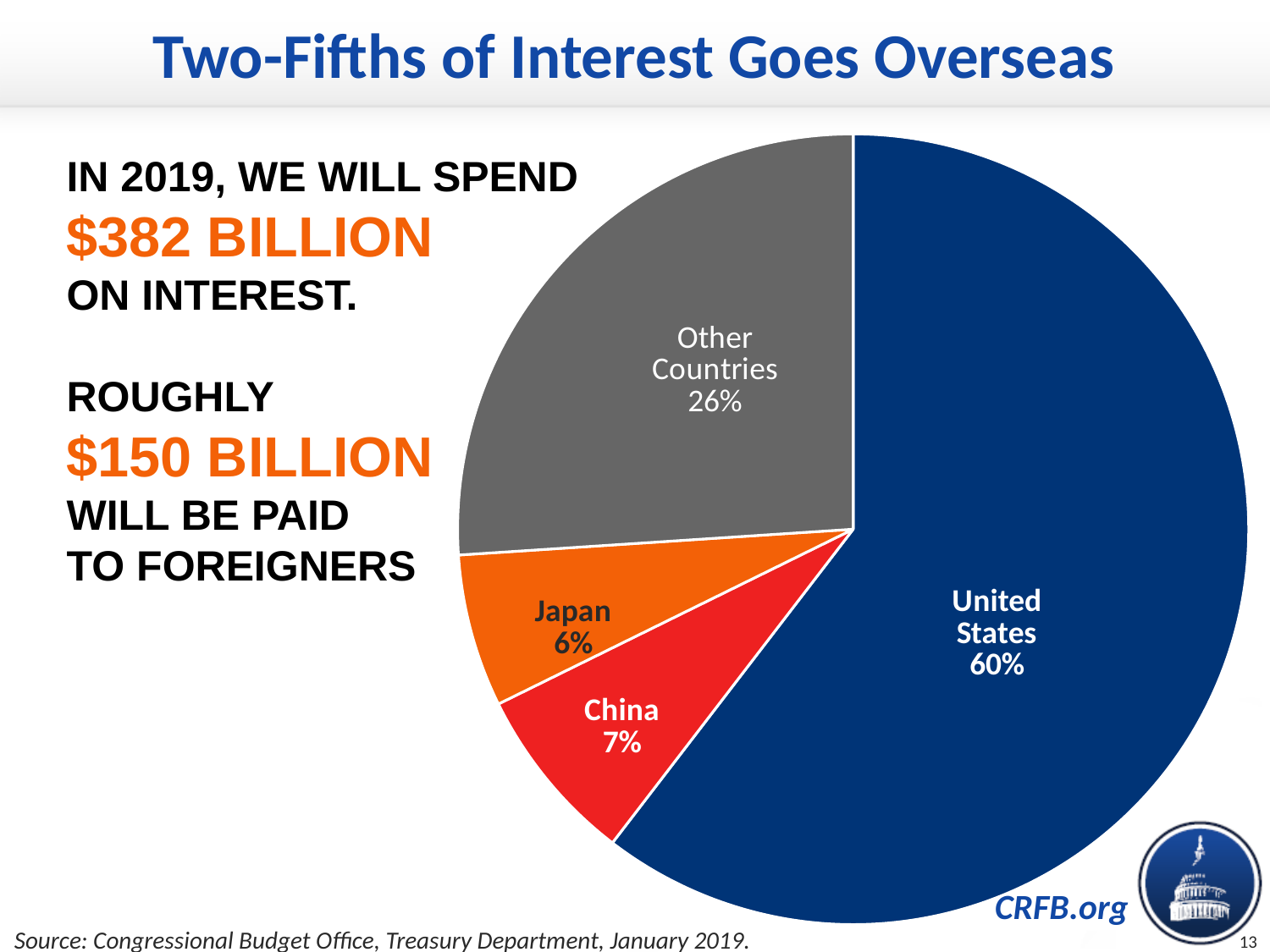
What share of the pie does the United States hold? 60% What share of the pie do Other Countries hold? 26% How many slices does the pie chart have? 4 What colour is the United States slice? Dark blue What share of the pie does Japan hold? 6% What is the combined share of China and Japan? 13% Which is larger, the China slice or the Japan slice? China What share of the pie does China hold? 7% What kind of chart is shown on the slide? Pie chart What is the difference in percentage points between the United States slice and the Other Countries slice? 34 percentage points Which slice of the pie is the largest? United States Which slice of the pie is the smallest? Japan